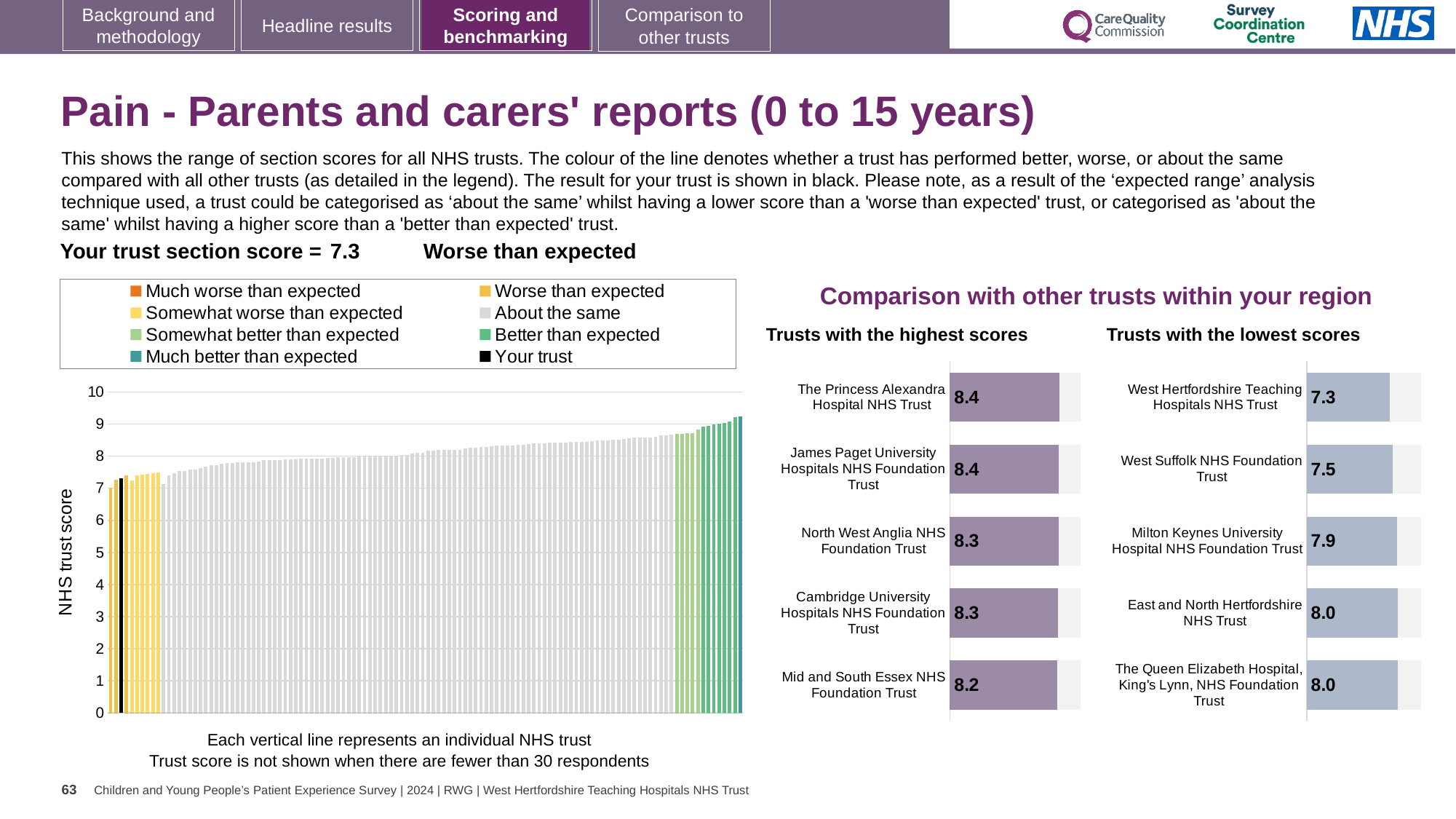
In the large chart on the left, is the value of the tallest bar greater or less than 9? greater In the 'Trusts with the highest scores' chart, what is the difference between the scores of The Princess Alexandra Hospital NHS Trust and Mid and South Essex NHS Foundation Trust? 0.2 In the large chart on the left, do the trust scores rise or fall from left to right? Rise In the 'Trusts with the lowest scores' chart, which has the larger score: Milton Keynes University Hospital NHS Foundation Trust or East and North Hertfordshire NHS Trust? East and North Hertfordshire NHS Trust What is the y-axis label of the large chart on the left? NHS trust score In the 'Trusts with the highest scores' chart, what is the score for The Princess Alexandra Hospital NHS Trust? 8.4 In the 'Trusts with the lowest scores' chart, what is the score for Milton Keynes University Hospital NHS Foundation Trust? 7.9 How many trusts are shown in the 'Trusts with the highest scores' chart? 5 In the 'Trusts with the lowest scores' chart, what is the score for West Suffolk NHS Foundation Trust? 7.5 What kind of chart is the large chart on the left showing NHS trust scores? Bar chart How many entries does the legend of the large chart on the left list? 8 In the 'Trusts with the lowest scores' chart, which trust has the lowest score? West Hertfordshire Teaching Hospitals NHS Trust